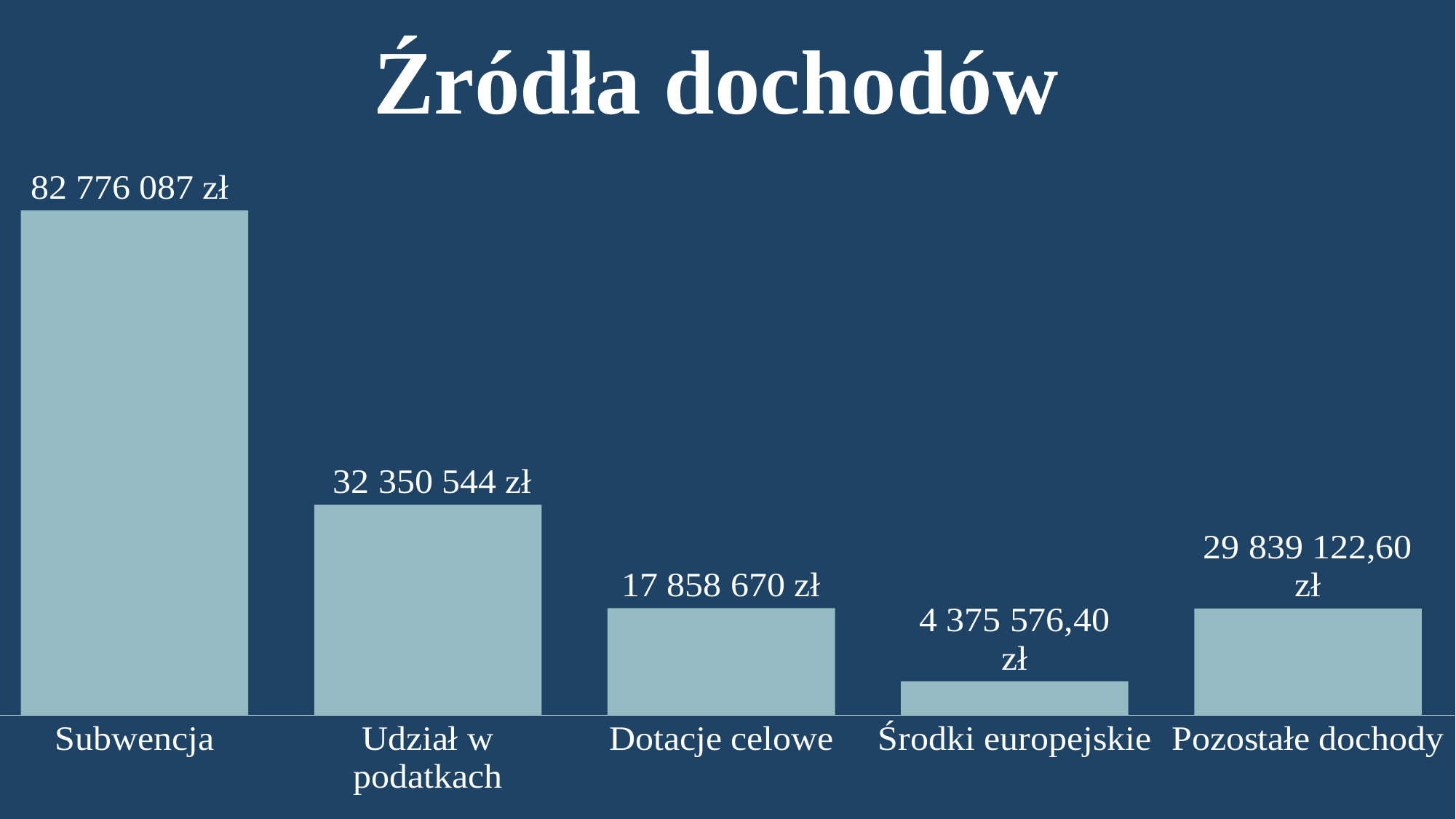
What is the value for Środki europejskie? 4 375 576,40 zł How many categories are shown in the chart? 5 What is the value for Pozostałe dochody? 29 839 122,60 zł What is the difference between the values for Subwencja and Udział w podatkach? 50 425 543 zł Which category has the highest value? Subwencja Which category has the lowest value? Środki europejskie What is the difference between the values for Dotacje celowe and Środki europejskie? 13 483 093,60 zł What kind of chart is shown on the slide? Bar chart What is the value for Subwencja? 82 776 087 zł Which is larger, the value for Udział w podatkach or the value for Pozostałe dochody? Udział w podatkach What is the value for Dotacje celowe? 17 858 670 zł What is the value for Udział w podatkach? 32 350 544 zł